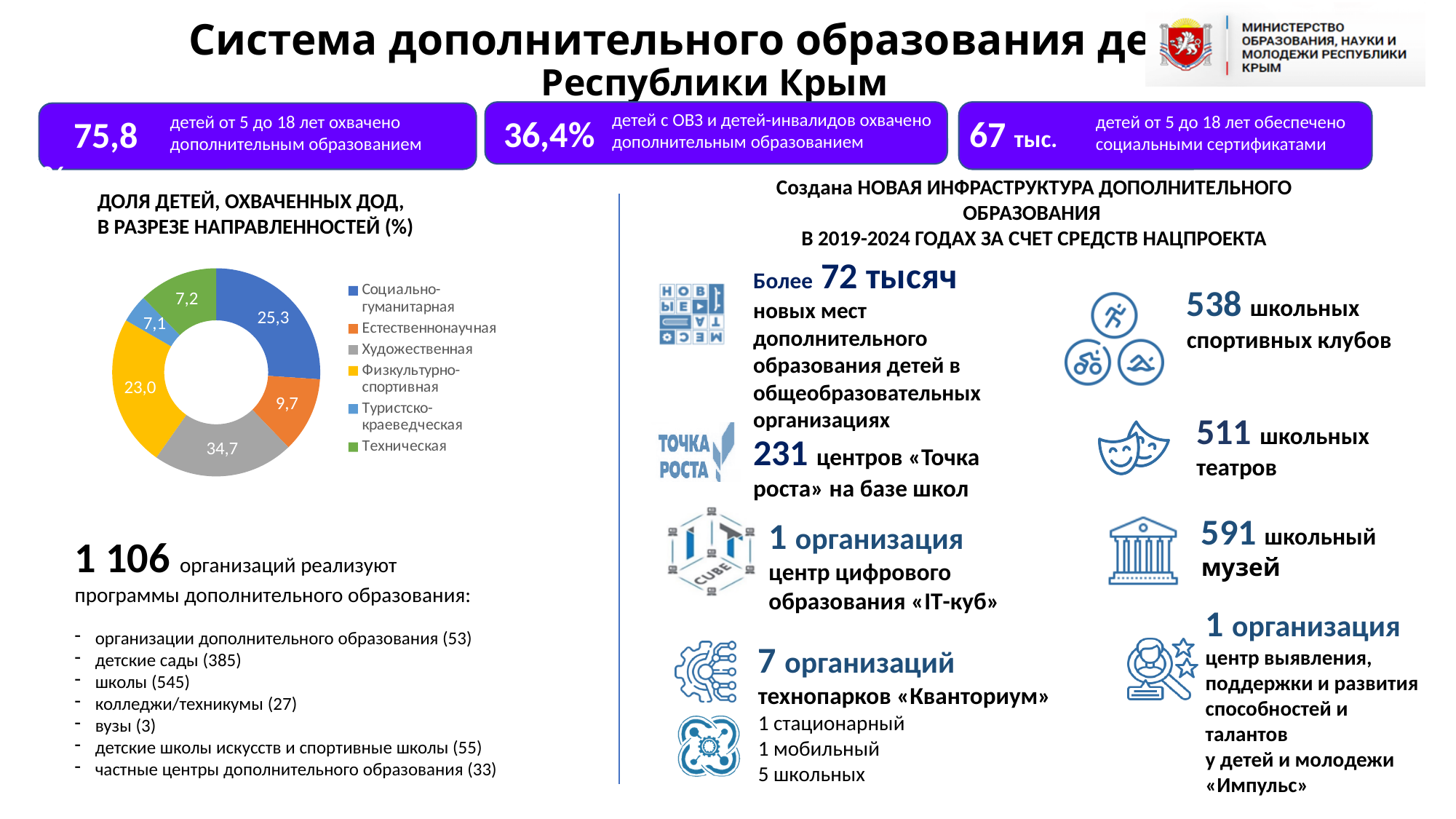
How many categories does the doughnut chart show? 6 What kind of chart is shown on the slide? Doughnut (pie) chart What is the value for Физкультурно-спортивная in the doughnut chart? 23,0 What is the value for Техническая in the doughnut chart? 7,2 What is the value for Социально-гуманитарная in the doughnut chart? 25,3 What is the value for Туристско-краеведческая in the doughnut chart? 7,1 What is the value for Естественнонаучная in the doughnut chart? 9,7 Which category has the largest share in the doughnut chart? Художественная What is the title of the doughnut chart? ДОЛЯ ДЕТЕЙ, ОХВАЧЕННЫХ ДОД, В РАЗРЕЗЕ НАПРАВЛЕННОСТЕЙ (%) Which is larger in the doughnut chart: Физкультурно-спортивная or Естественнонаучная? Физкультурно-спортивная What is the value for Художественная in the doughnut chart? 34,7 What is the difference between the values for Художественная and Социально-гуманитарная? 9,4